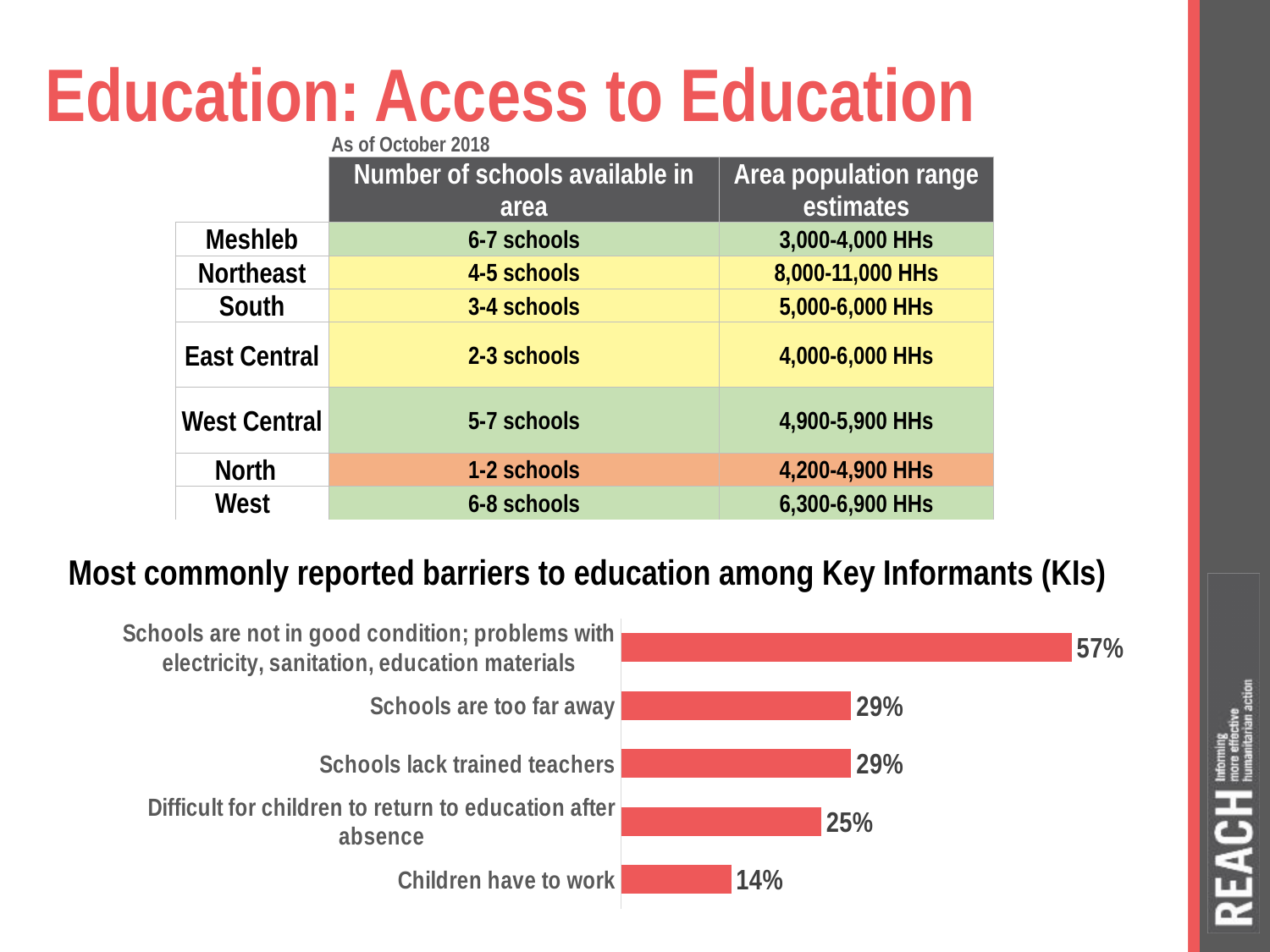
What percentage of KIs reported 'Children have to work' as a barrier to education? 14% What percentage of KIs reported 'Difficult for children to return to education after absence' as a barrier? 25% What is the difference in percentage points between 'Schools lack trained teachers' and 'Children have to work'? 15 How many barriers to education are shown in the bar chart? 5 Which was reported by more KIs: 'Difficult for children to return to education after absence' or 'Children have to work'? Difficult for children to return to education after absence Which barrier to education was least commonly reported by KIs? Children have to work Which barrier to education was most commonly reported by KIs? Schools are not in good condition; problems with electricity, sanitation, education materials What type of chart is used to show the most commonly reported barriers to education? Bar chart What is the difference in percentage points between 'Schools are not in good condition' and 'Schools are too far away'? 28 Do 'Schools are too far away' and 'Schools lack trained teachers' have the same reported percentage? Yes, both 29% What percentage of KIs reported that schools are not in good condition (problems with electricity, sanitation, education materials) as a barrier to education? 57% What is the title of the chart on the slide? Most commonly reported barriers to education among Key Informants (KIs)